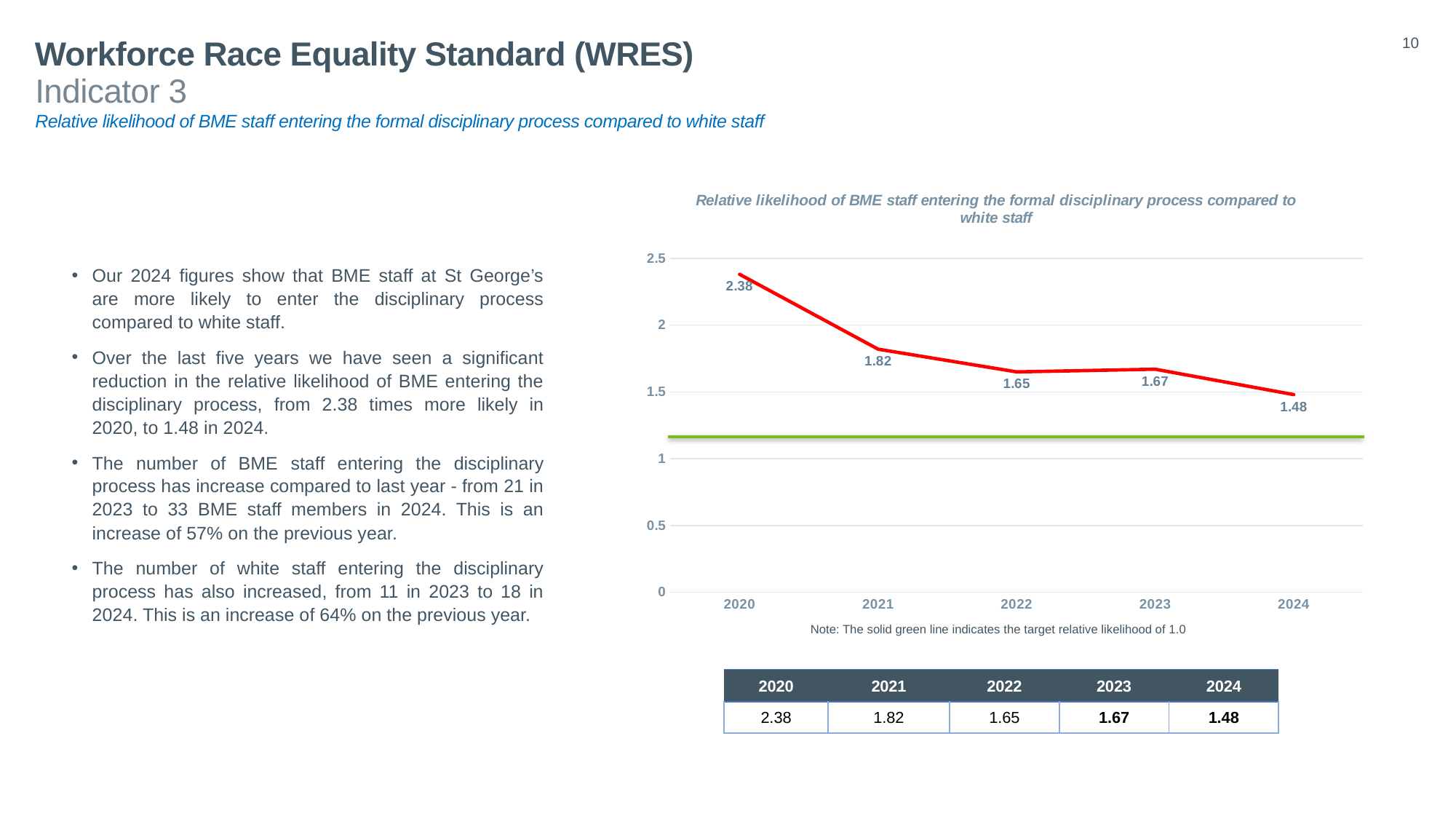
What is the relative likelihood value for 2024? 1.48 What kind of chart is shown on the slide? line chart Which year has the lowest relative likelihood value? 2024 Which year has the larger value, 2021 or 2023? 2021 What is the difference between the 2020 value and the 2024 value? 0.90 Does the red line generally rise or fall from 2020 to 2024? fall What is the relative likelihood value for 2020? 2.38 Which year has the highest relative likelihood value? 2020 What is the relative likelihood value for 2022? 1.65 What is the difference between the 2021 value and the 2022 value? 0.17 Is the value for 2021 greater or less than 2? less How many years are plotted on the x axis? 5